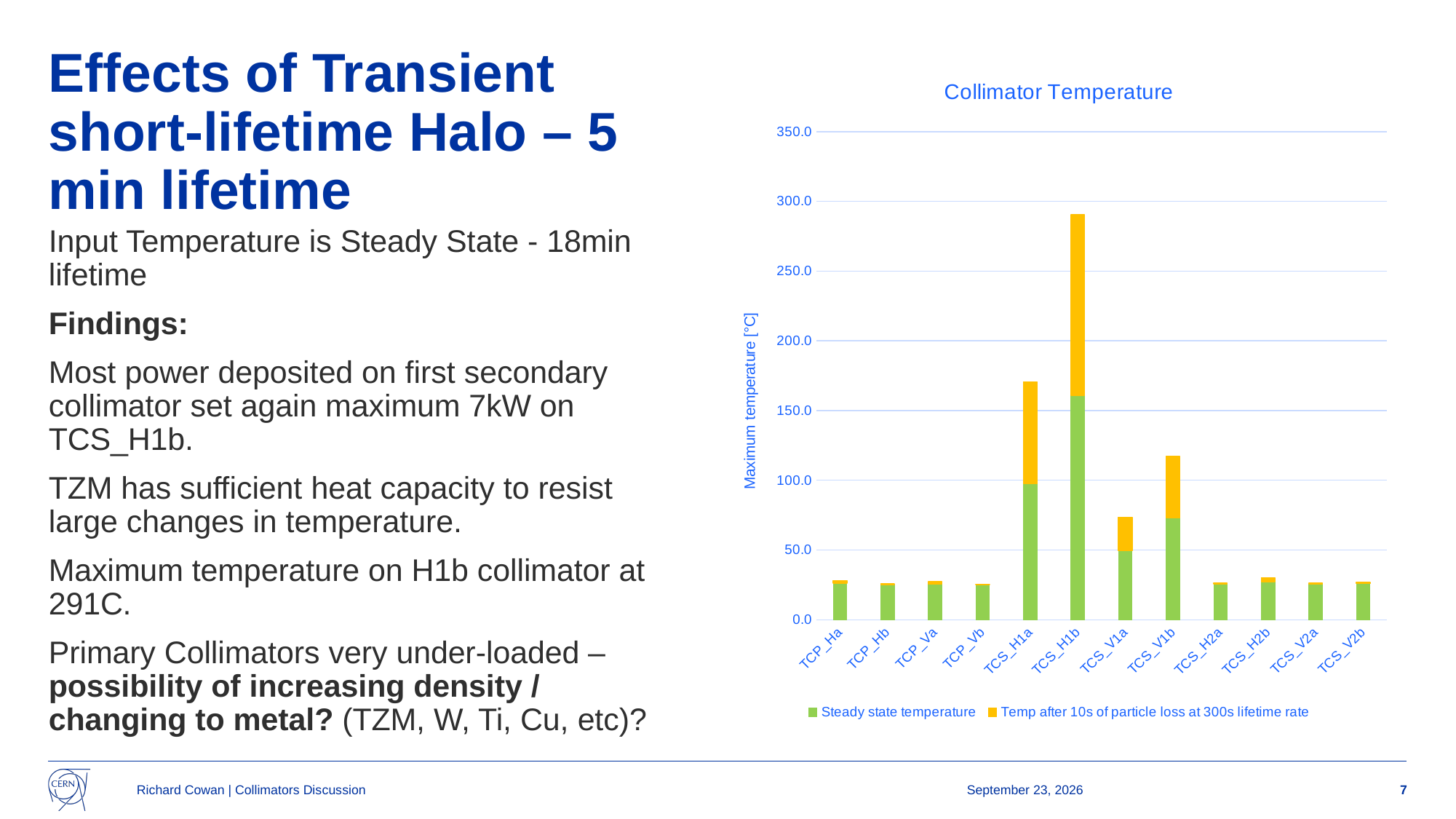
What kind of chart is shown on the slide? Stacked bar chart Which collimator has the highest total maximum temperature? TCS_H1b Is the total bar height for TCP_Ha greater or less than 50.0? less Is the total bar height for TCS_H1b greater or less than 250.0? greater Is the total bar height for TCS_H1a greater or less than 150.0? greater What is the title of the chart? Collimator Temperature Which has the larger total bar, TCS_H1a or TCS_V1b? TCS_H1a How many series does the legend list? 2 How many collimator categories are plotted along the x axis? 12 Which colour represents the 'Steady state temperature' series in the legend? Green